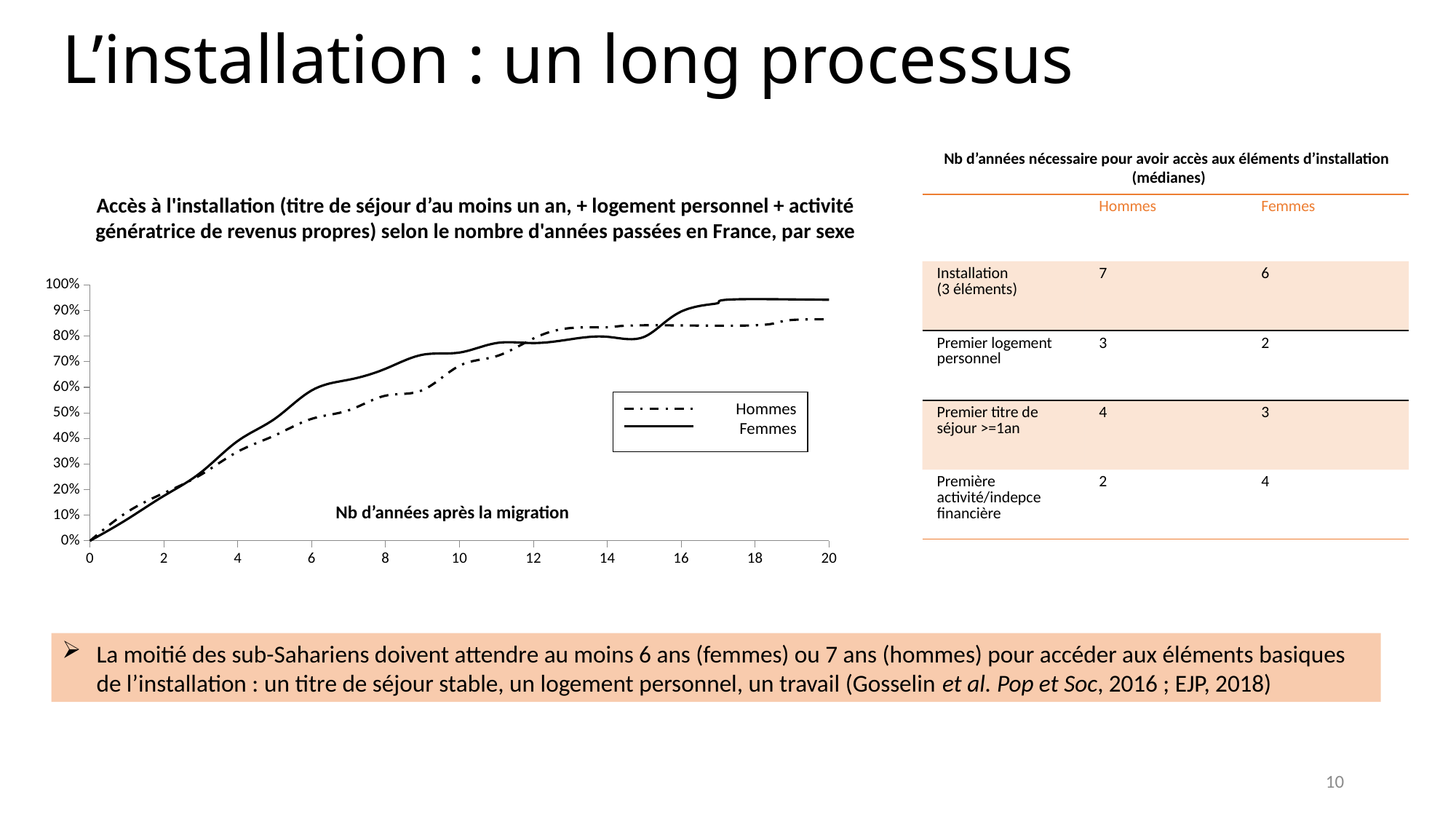
Is the value for Femmes at 10 years greater or less than 70%? greater Is the value for Hommes at 4 years greater or less than 30%? greater At 8 years after migration, which series has the higher value, Hommes or Femmes? Femmes Which two series are listed in the chart's legend? Hommes and Femmes Is the value for Hommes at 20 years greater or less than 90%? less What kind of chart is shown on the slide? line chart Do the values for Femmes rise or fall as the number of years after migration increases? rise What is the label shown for the x axis of the chart? Nb d'années après la migration How many series does the chart's legend list? 2 At 20 years after migration, which series has the higher value, Hommes or Femmes? Femmes